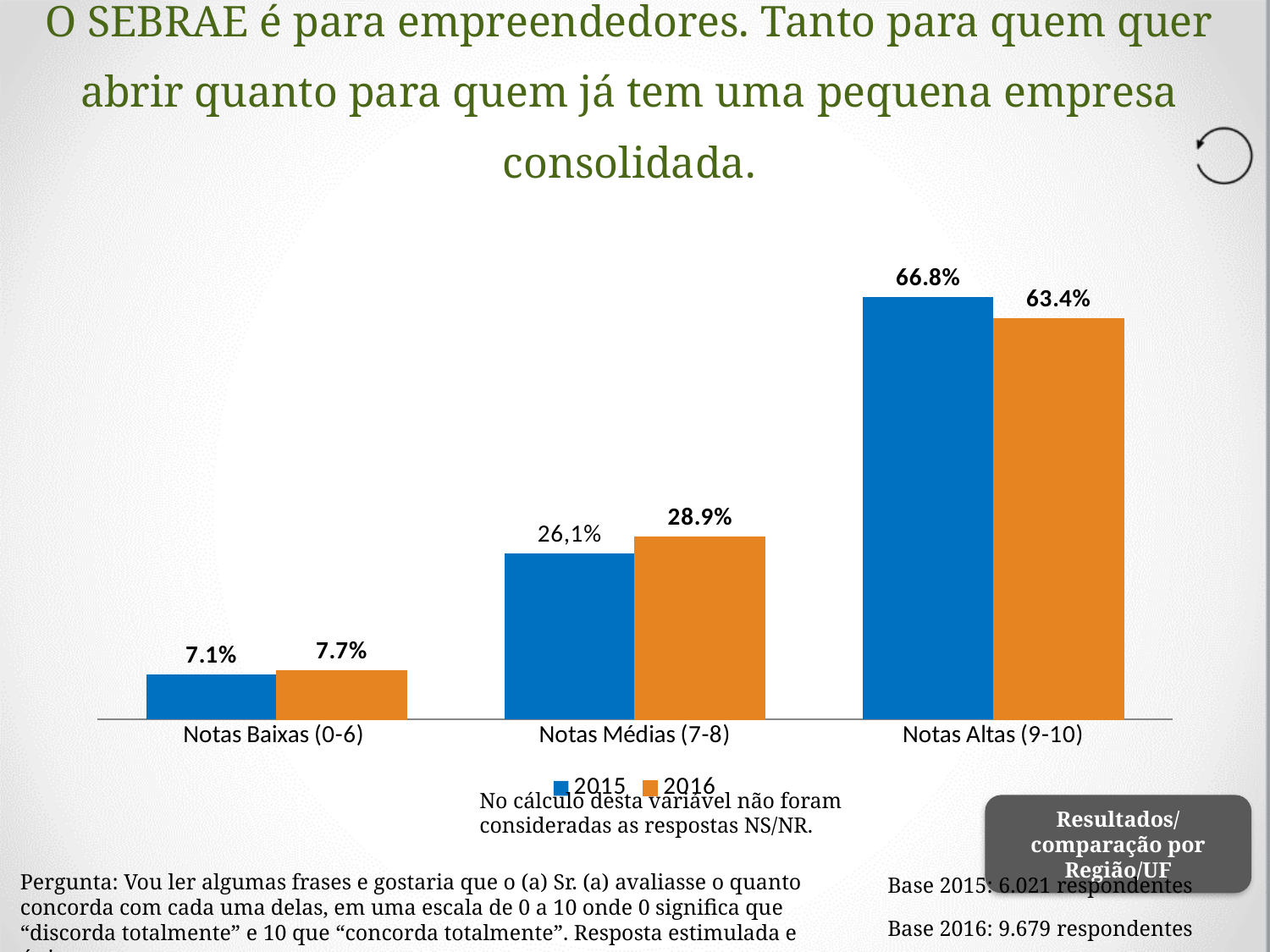
What is the value for 2016 in the Notas Baixas (0-6) category? 7.7% Which category has the highest value for the 2016 series? Notas Altas (9-10) What is the difference between the 2015 and 2016 values in the Notas Altas (9-10) category? 3.4 percentage points Which category has the lowest value for the 2015 series? Notas Baixas (0-6) What is the difference between the 2016 and 2015 values in the Notas Baixas (0-6) category? 0.6 percentage points How many series does the chart legend list? 2 In the Notas Médias (7-8) category, which series has the larger value, 2015 or 2016? 2016 What kind of chart is shown on the slide? Bar chart What is the value for 2016 in the Notas Altas (9-10) category? 63.4% How many categories are shown on the x axis of the chart? 3 What is the value for 2015 in the Notas Altas (9-10) category? 66.8% What is the value for 2015 in the Notas Médias (7-8) category? 26,1%